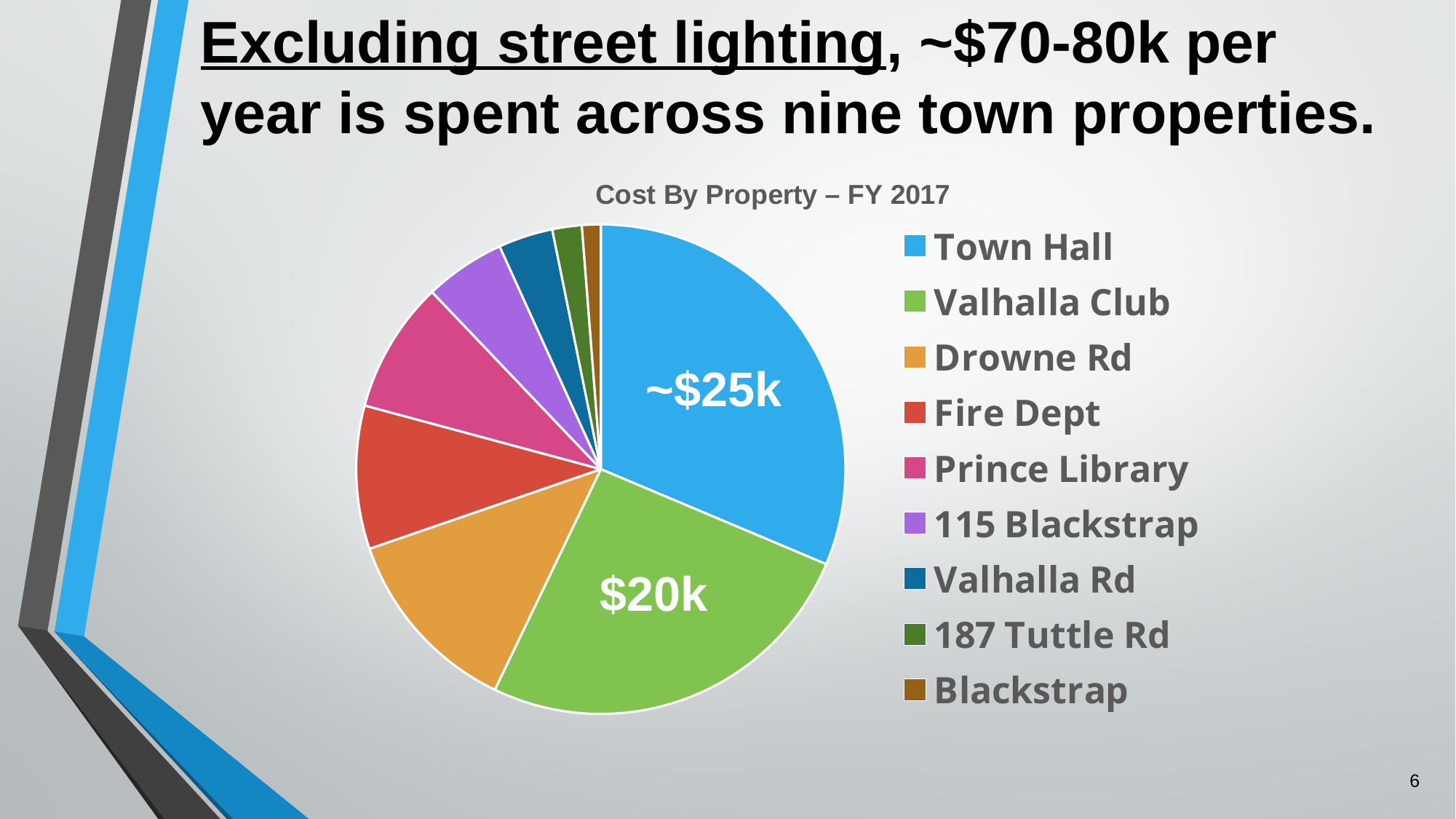
What is the title of the chart? Cost By Property – FY 2017 Which is larger, the slice for Town Hall or the slice for Valhalla Club? Town Hall What kind of chart is shown on the slide? pie chart Which property has the largest slice of the pie? Town Hall What colour is the Town Hall slice in the pie chart? blue Which is larger, the slice for Valhalla Club or the slice for Drowne Rd? Valhalla Club Which is larger, the slice for Drowne Rd or the slice for Fire Dept? Drowne Rd Which property is listed last in the legend? Blackstrap How many properties (slices) does the pie chart show? 9 What is the cost shown for Valhalla Club? $20k